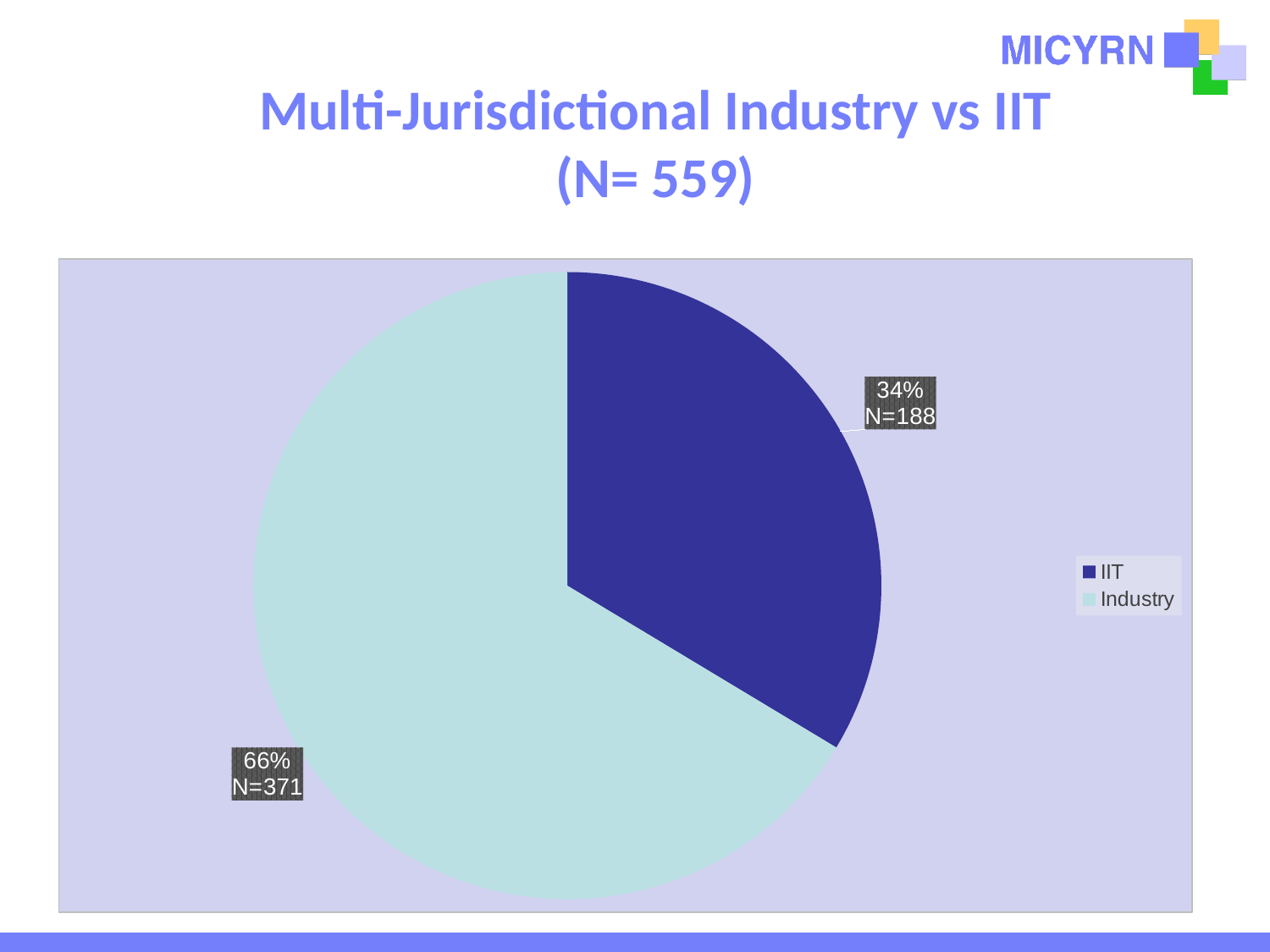
What is the N value shown for the IIT slice? N=188 What percentage of the pie does the Industry slice represent? 66% What kind of chart is shown on the slide? pie chart What is the difference in count between the Industry slice and the IIT slice? 183 Which slice is larger, IIT or Industry? Industry How many entries does the legend list? 2 How many slices does the pie chart have? 2 Which category has the smallest share of the pie? IIT What is the title of the chart on the slide? Multi-Jurisdictional Industry vs IIT (N= 559) What percentage of the pie does the IIT slice represent? 34% Which category has the largest share of the pie? Industry What is the N value shown for the Industry slice? N=371